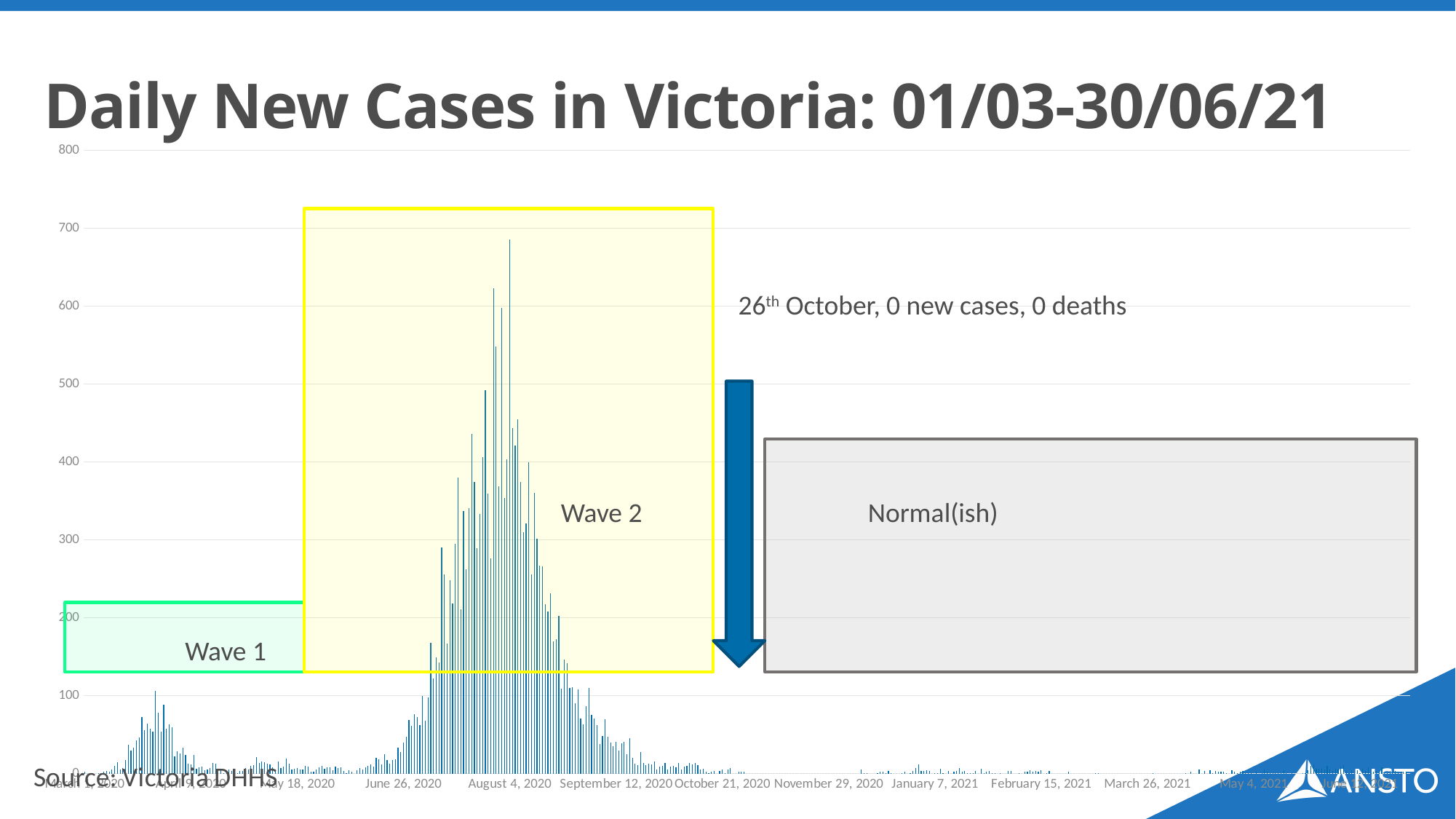
Is the highest daily value in the Wave 2 period greater or less than 700? less Which period has the lowest daily new cases: Wave 1, Wave 2, or Normal(ish)? Normal(ish) What is the highest value shown on the vertical axis? 800 What kind of chart is shown on the slide? bar chart Do daily new cases rise or fall between the Wave 2 peak and the period labelled Normal(ish)? fall According to the annotation, how many new cases were recorded on 26th October? 0 What is the title of the chart? Daily New Cases in Victoria: 01/03-30/06/21 Is the highest daily value in the Wave 1 period greater or less than 200? less Which wave reached a higher peak of daily new cases, Wave 1 or Wave 2? Wave 2 According to the annotation, how many deaths were recorded on 26th October? 0 Is the highest daily value in the Wave 1 period greater or less than 50? greater